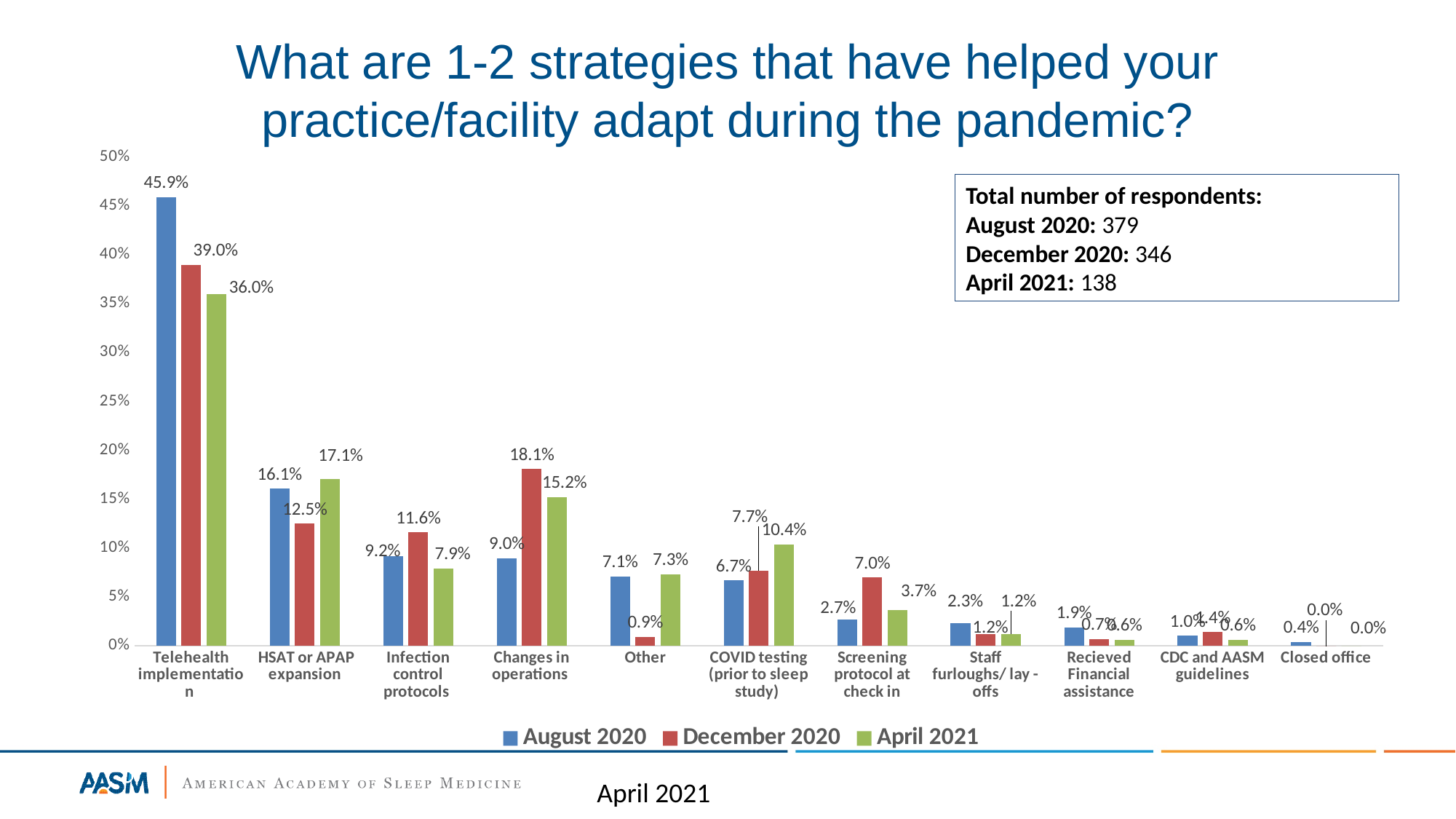
What kind of chart is shown on the slide? Bar chart What is the difference between the August 2020 and April 2021 values for Telehealth implementation? 9.9% Which category has the lowest August 2020 value? Closed office How many categories are shown on the x axis? 11 Which category has the highest April 2021 value? Telehealth implementation What is the April 2021 value for COVID testing (prior to sleep study)? 10.4% Is the December 2020 value for Telehealth implementation greater or less than 35%? greater What is the December 2020 value for Other? 0.9% How many series does the legend list? 3 Which is larger for HSAT or APAP expansion: the December 2020 value or the April 2021 value? April 2021 What is the December 2020 value for Changes in operations? 18.1% What is the August 2020 value for Telehealth implementation? 45.9%